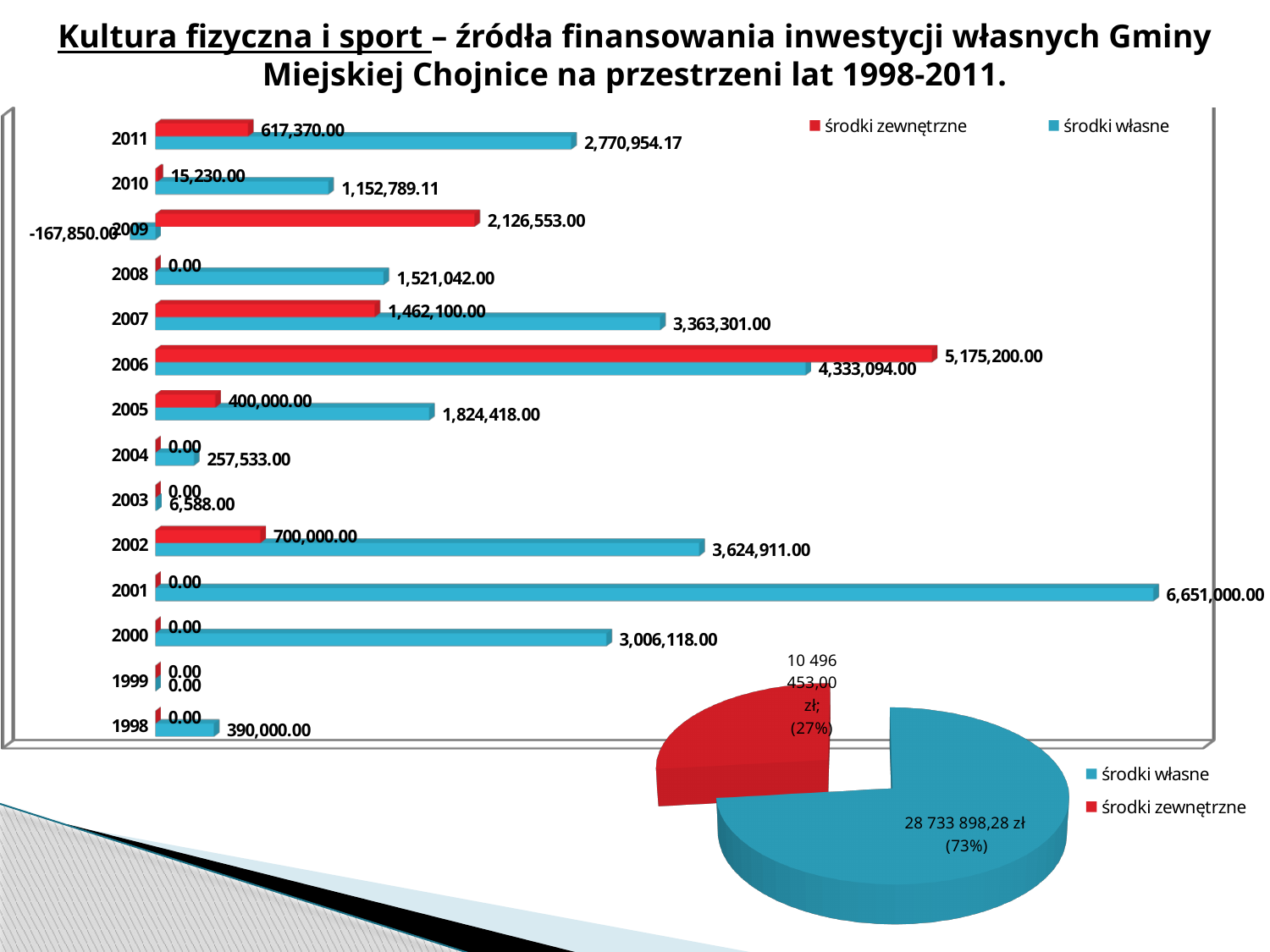
How many years are shown in the bar chart? 14 In the bar chart, which year has the highest value of środki zewnętrzne? 2006 In the bar chart, what is the value of środki własne for 2011? 2,770,954.17 In the bar chart, what is the value of środki zewnętrzne for 2010? 15,230.00 In the bar chart, what is the value of środki zewnętrzne for 2006? 5,175,200.00 In the bar chart, which is larger for 2007: środki zewnętrzne or środki własne? środki własne In the bar chart, what is the value of środki własne for 2001? 6,651,000.00 In the bar chart, which year has the highest value of środki własne? 2001 How many series does the legend of the bar chart list? 2 In the pie chart, what share of the total is środki własne? 73% In the bar chart, what is the difference between środki zewnętrzne and środki własne in 2006? 842,106.00 What kind of chart is the chart at the bottom right of the slide? Pie chart